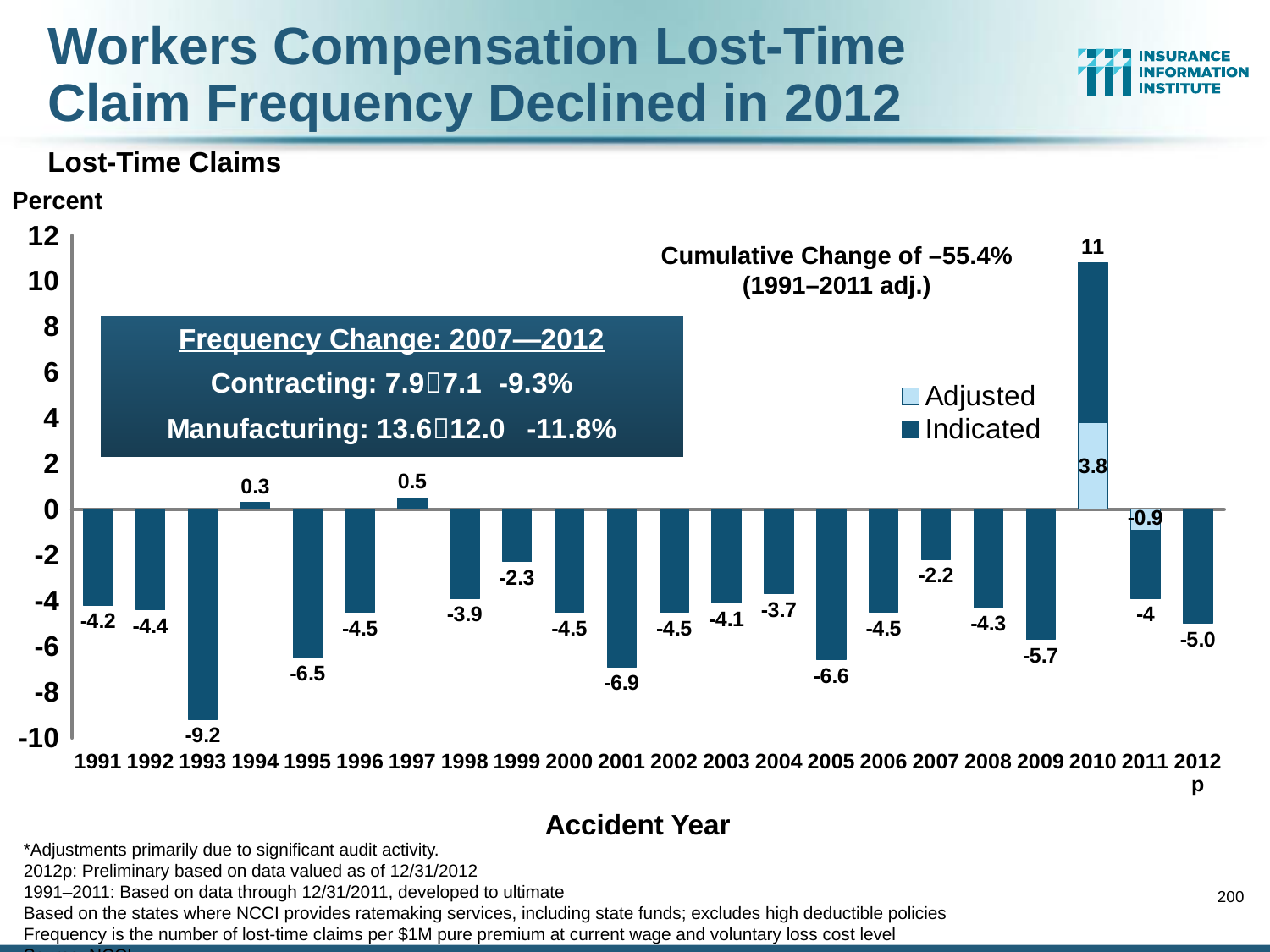
Which accident year has the lowest value? 1993 Which is larger, the value for 1995 or the value for 2009? 2009 What is the value for 2012p? -5.0 What kind of chart is this? Bar chart What is the value for 1993? -9.2 What is the difference between the values for 2001 and 2005? 0.3 What is the value for 1997? 0.5 Which accident year has the highest value? 2010 What is the Adjusted value shown for 2010? 3.8 How many accident years are shown on the x axis? 22 How many series does the legend list? 2 What cumulative change for 1991–2011 (adj.) is noted on the chart? –55.4%